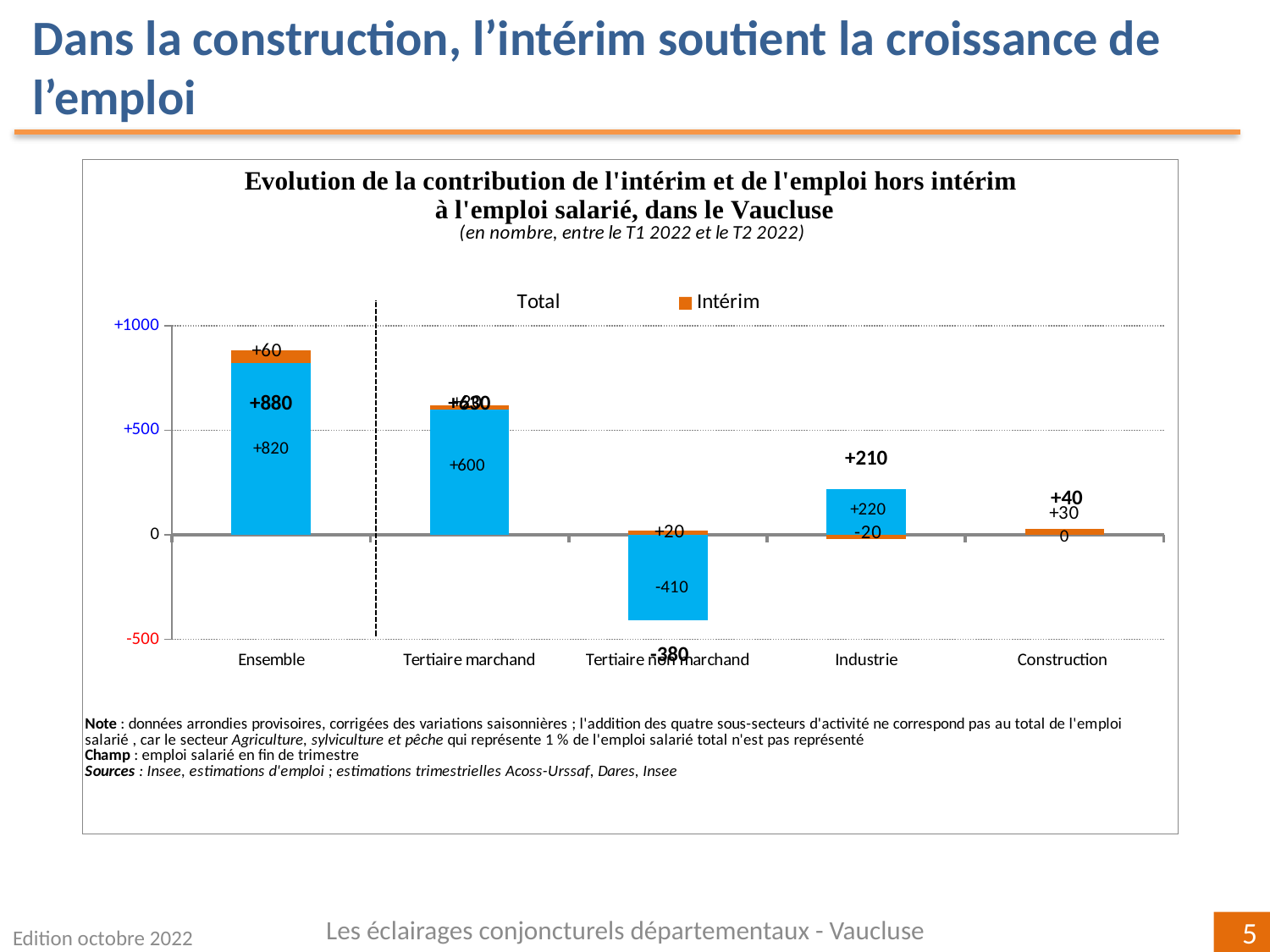
What kind of chart is shown on the slide? bar chart What is the Total value shown for Ensemble? +880 What is the value of the blue (hors intérim) bar for Tertiaire non marchand? -410 How many sector categories are shown on the x axis? 5 What is the Total value shown for Construction? +40 What is the Total value shown for Industrie? +210 Which category has the lowest Total value? Tertiaire non marchand Which category has the highest Total value? Ensemble Is the blue (hors intérim) bar for Tertiaire marchand greater or less than +500? greater What is the Intérim value for Industrie? -20 What is the Intérim value for Ensemble? +60 What is the difference between the Total value for Ensemble and the Total value for Industrie? 670